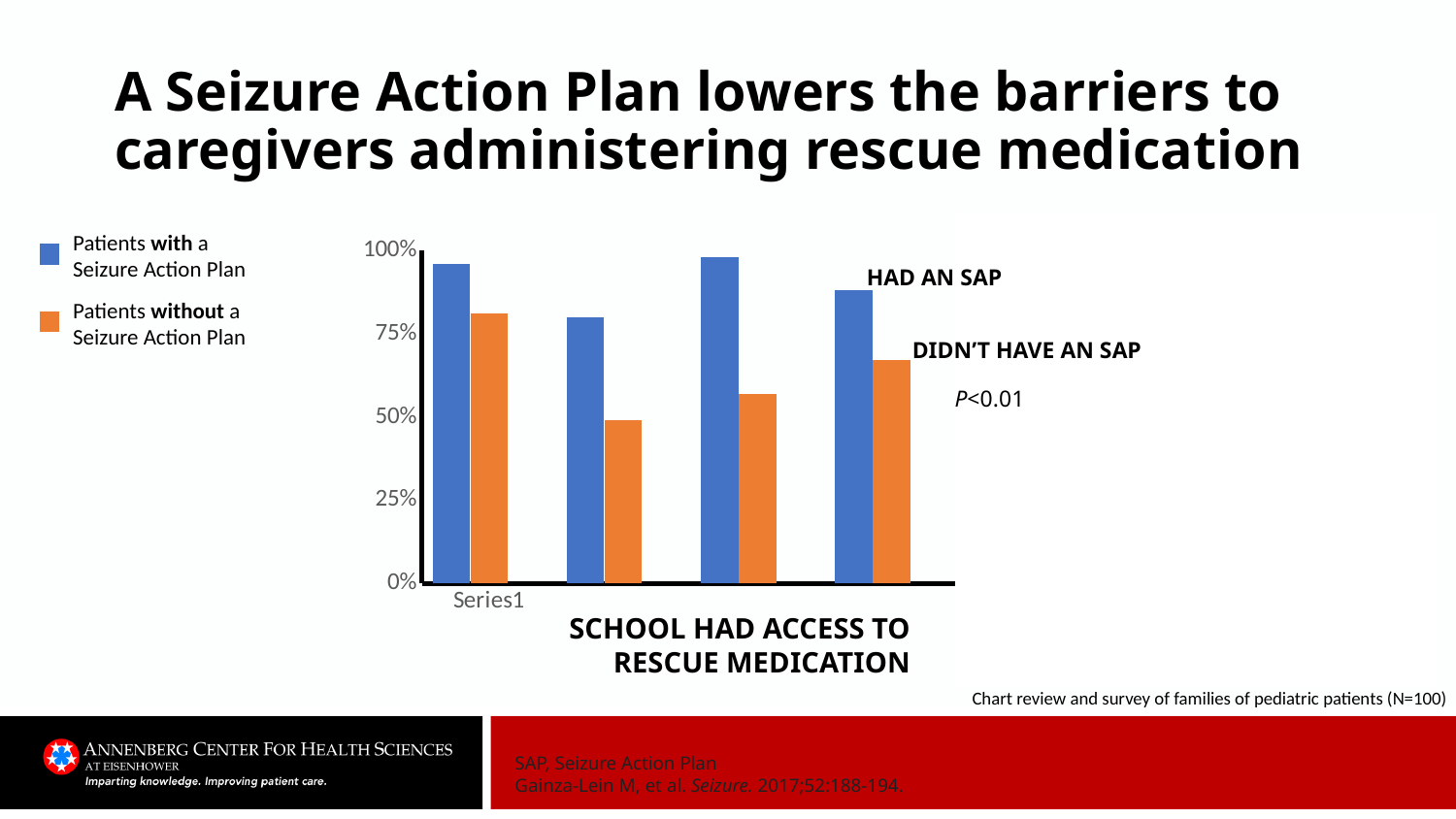
Among the orange bars (patients without a Seizure Action Plan), which group of bars has the lowest value? the second group What P value is shown on the chart? P<0.01 How many groups of bars are plotted along the x axis? 4 In the Series1 group, which is larger: the value for patients with a Seizure Action Plan or patients without a Seizure Action Plan? Patients with a Seizure Action Plan Which colour represents patients with a Seizure Action Plan? blue Is the value for patients with a Seizure Action Plan in the third group of bars greater or less than 75%? greater How many series does the legend list? 2 Is the value for patients without a Seizure Action Plan in the fourth (rightmost) group of bars greater or less than 75%? less Is the value for patients with a Seizure Action Plan in the Series1 group greater or less than 75%? greater What kind of chart is shown on the slide? bar chart Among the orange bars (patients without a Seizure Action Plan), which group of bars has the highest value? Series1 (the first group)